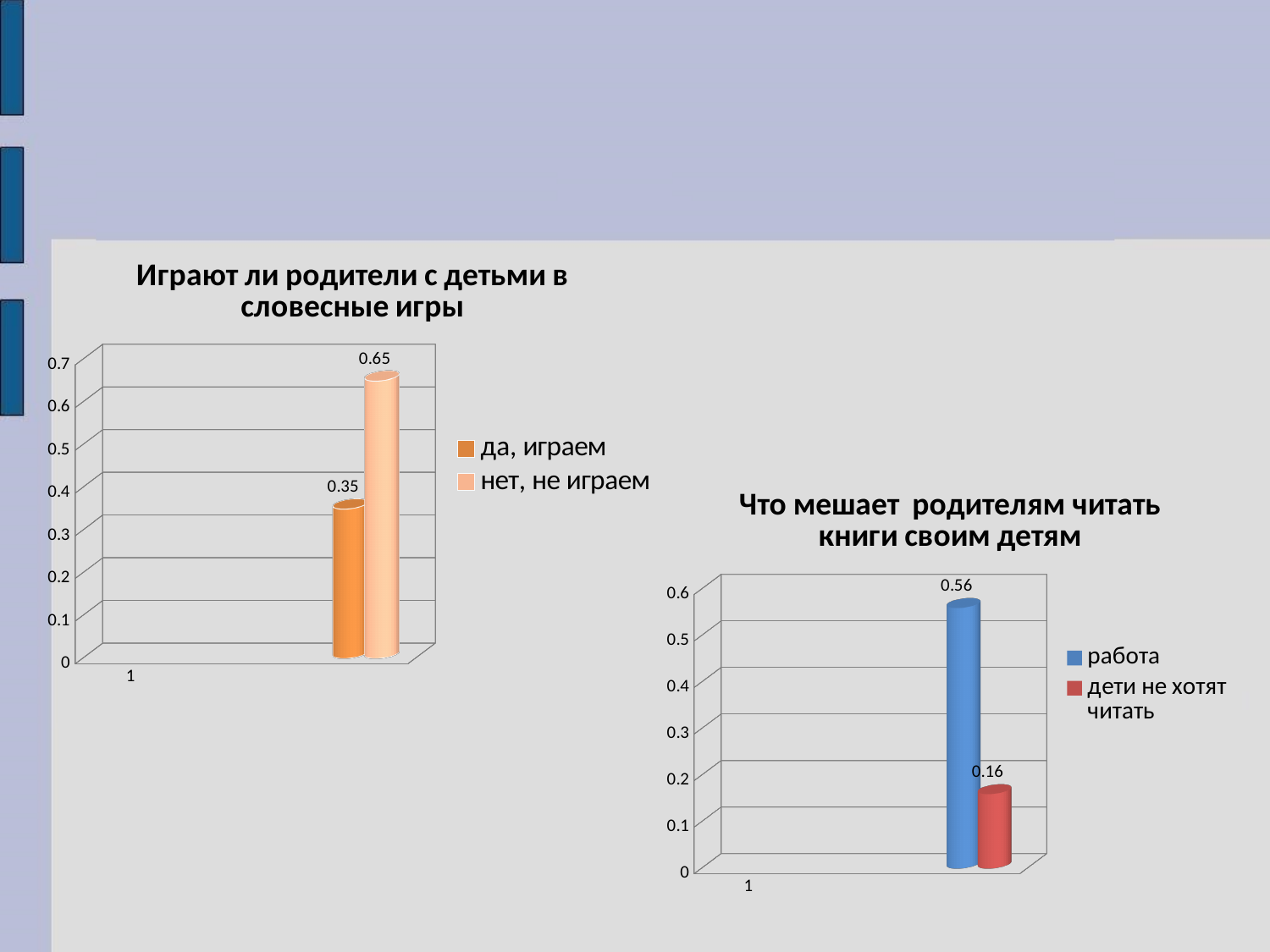
In the chart titled "Играют ли родители с детьми в словесные игры", what is the value for "нет, не играем"? 0.65 In the chart titled "Играют ли родители с детьми в словесные игры", how many series does the legend list? 2 In the chart titled "Что мешает родителям читать книги своим детям", what is the value for "дети не хотят читать"? 0.16 In the chart titled "Что мешает родителям читать книги своим детям", is the value for "работа" greater or less than 0.5? greater In the chart titled "Что мешает родителям читать книги своим детям", which series has the lower value? дети не хотят читать In the chart titled "Играют ли родители с детьми в словесные игры", what is the value for "да, играем"? 0.35 In the chart titled "Что мешает родителям читать книги своим детям", what colour is the bar for "работа"? blue In the chart titled "Что мешает родителям читать книги своим детям", what is the value for "работа"? 0.56 In the chart titled "Играют ли родители с детьми в словесные игры", which series has the higher value? нет, не играем In the chart titled "Что мешает родителям читать книги своим детям", what is the difference between the values for "работа" and "дети не хотят читать"? 0.4 In the chart titled "Играют ли родители с детьми в словесные игры", what is the difference between the values for "нет, не играем" and "да, играем"? 0.3 What kind of chart is the chart titled "Что мешает родителям читать книги своим детям"? bar chart